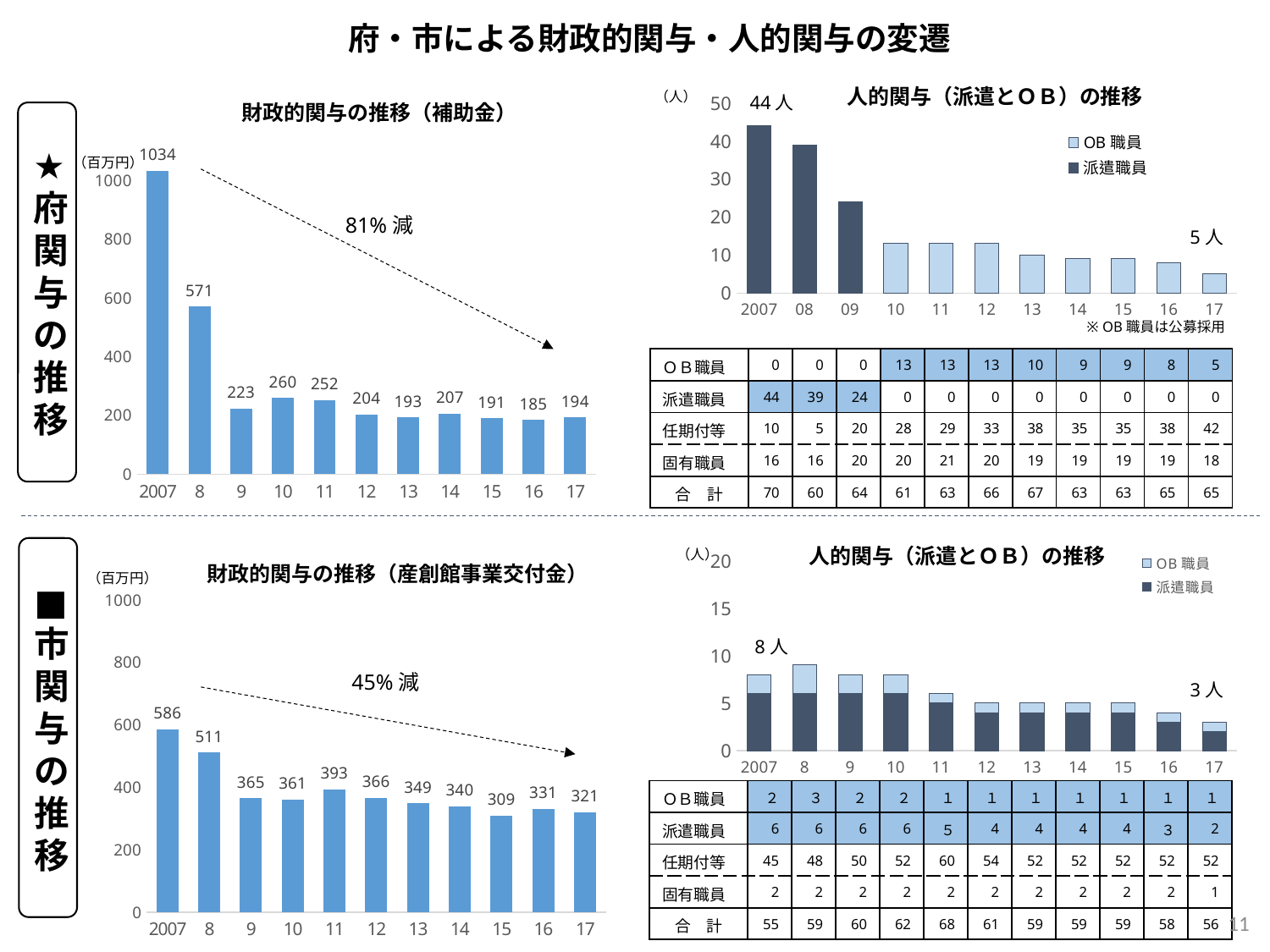
In the top-right chart 人的関与（派遣とＯＢ）の推移, what is the value of 派遣職員 for 2007? 44 In the top-left chart 財政的関与の推移（補助金）, which year has the lowest value? 16 In the bottom-left chart 財政的関与の推移（産創館事業交付金）, what kind of chart is it? bar chart In the bottom-left chart 財政的関与の推移（産創館事業交付金）, what is the value for 11? 393 In the top-right chart 人的関与（派遣とＯＢ）の推移, how many series does the legend list? 2 In the bottom-right chart 人的関与（派遣とＯＢ）の推移, do the 派遣職員 values generally rise or fall from 2007 to 17? fall In the bottom-left chart 財政的関与の推移（産創館事業交付金）, which is larger, the value for 15 or the value for 16? 16 In the top-left chart 財政的関与の推移（補助金）, how many years are plotted on the x axis? 11 In the top-left chart 財政的関与の推移（補助金）, what is the difference between the values for 2007 and 8? 463 In the top-left chart 財政的関与の推移（補助金）, what is the value for 2007? 1034 In the bottom-left chart 財政的関与の推移（産創館事業交付金）, which year has the highest value? 2007 In the bottom-right chart 人的関与（派遣とＯＢ）の推移, what is the total of the stacked bar for 8? 9